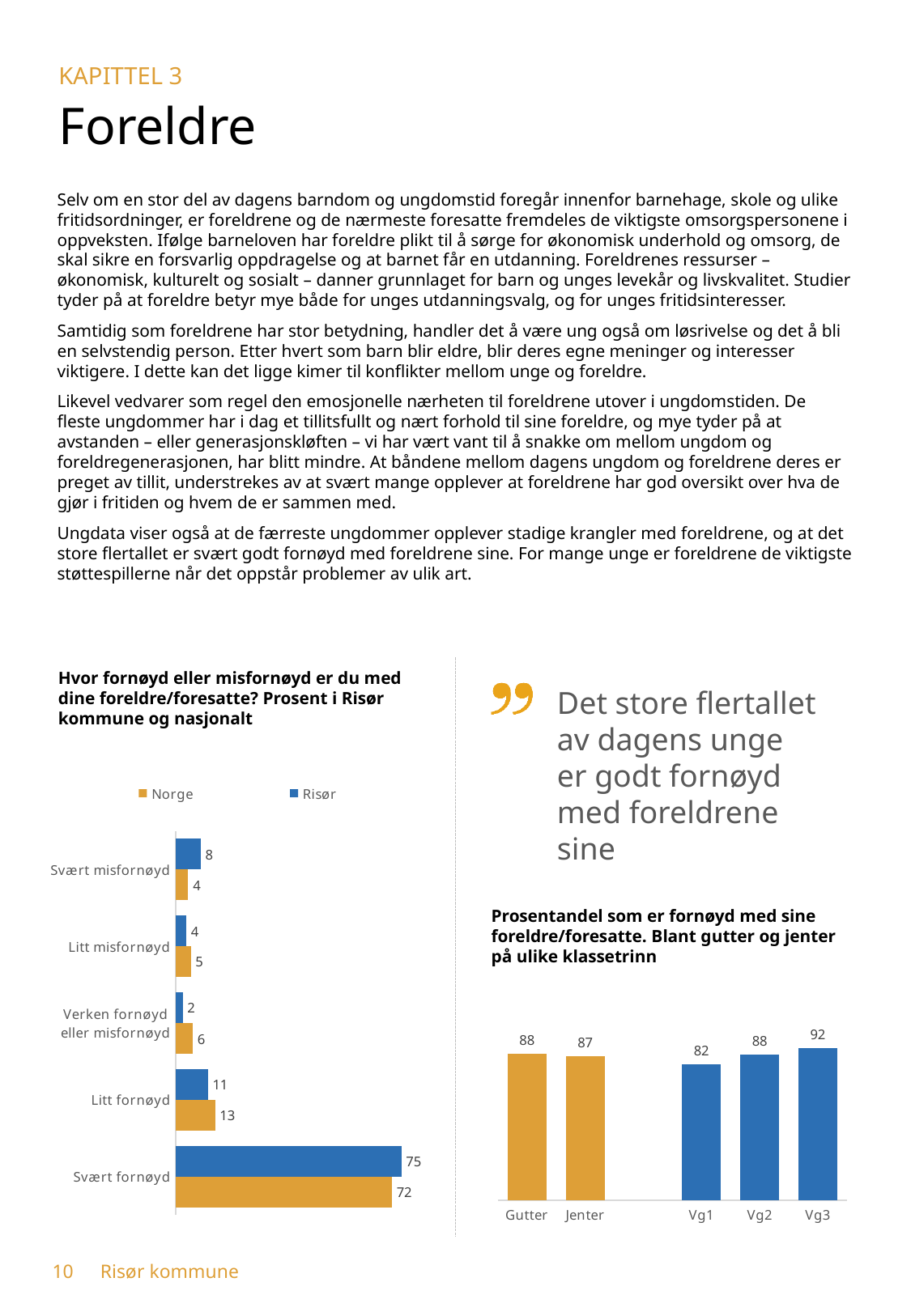
How many categories are shown in the chart 'Hvor fornøyd eller misfornøyd er du med dine foreldre/foresatte?'? 5 In the chart 'Hvor fornøyd eller misfornøyd er du med dine foreldre/foresatte?', what is the Risør value for 'Svært fornøyd'? 75 In the chart 'Hvor fornøyd eller misfornøyd er du med dine foreldre/foresatte?', which is larger for 'Verken fornøyd eller misfornøyd': Norge or Risør? Norge In the chart 'Hvor fornøyd eller misfornøyd er du med dine foreldre/foresatte?', what is the difference between the Risør and Norge values for 'Svært misfornøyd'? 4 In the chart 'Hvor fornøyd eller misfornøyd er du med dine foreldre/foresatte?', which category has the highest Norge value? Svært fornøyd What kind of chart is 'Hvor fornøyd eller misfornøyd er du med dine foreldre/foresatte?'? Bar chart In the chart 'Prosentandel som er fornøyd med sine foreldre/foresatte', which category has the highest value? Vg3 In the chart 'Hvor fornøyd eller misfornøyd er du med dine foreldre/foresatte?', which category has the lowest Risør value? Verken fornøyd eller misfornøyd How many series does the legend list in the chart 'Hvor fornøyd eller misfornøyd er du med dine foreldre/foresatte?'? 2 In the chart 'Prosentandel som er fornøyd med sine foreldre/foresatte', what is the value for Vg1? 82 In the chart 'Prosentandel som er fornøyd med sine foreldre/foresatte', what is the difference between Vg3 and Vg1? 10 In the chart 'Hvor fornøyd eller misfornøyd er du med dine foreldre/foresatte?', what is the Norge value for 'Litt fornøyd'? 13